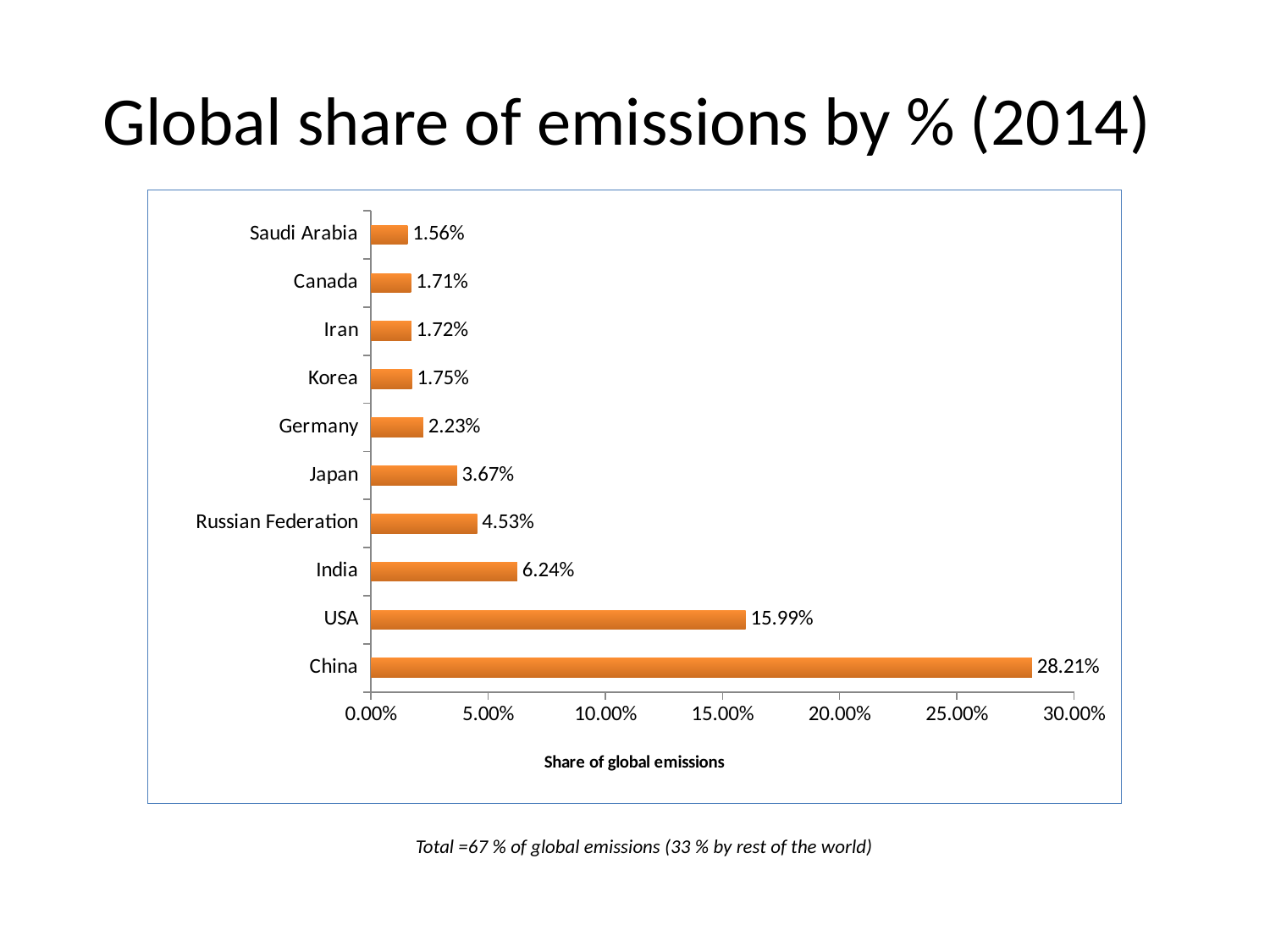
What is the share of global emissions for India? 6.24% Which country has the highest share of global emissions? China Is the value for the USA greater or less than 15.00%? greater What is the difference between the shares of China and the USA? 12.22% What is the label of the horizontal axis? Share of global emissions What is the share of global emissions for Germany? 2.23% What kind of chart is shown on the slide? Bar chart What is the share of global emissions for China? 28.21% What is the difference between the shares of the Russian Federation and Japan? 0.86% Which has a larger share of global emissions, India or Japan? India How many countries are shown in the chart? 10 Which country has the lowest share of global emissions? Saudi Arabia